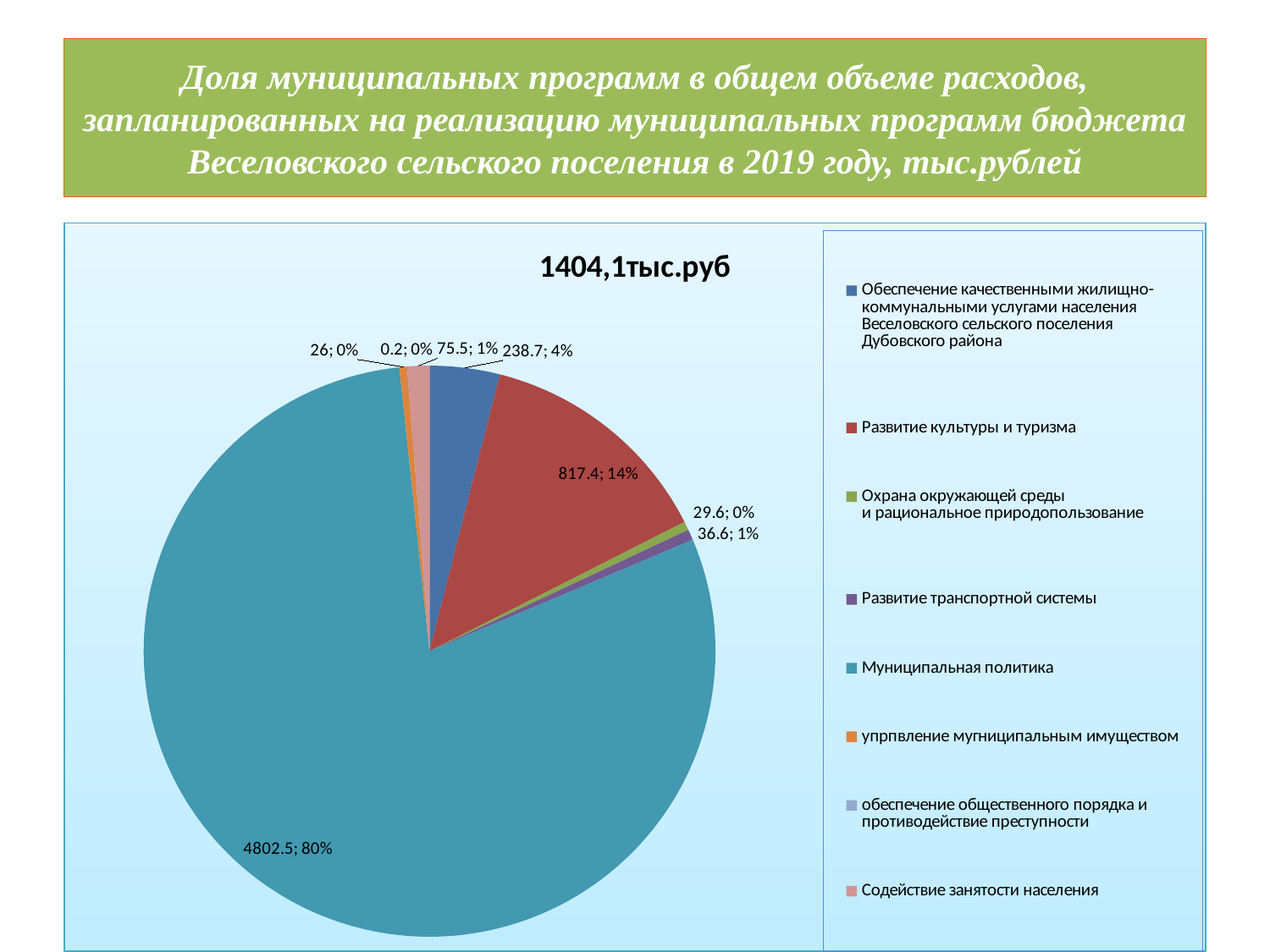
What value is shown for the Развитие культуры и туризма slice? 817.4 What is the smallest value labelled on the pie chart? 0.2 What is the title shown above the pie chart? 1404,1тыс.руб What share of the pie does the Развитие культуры и туризма slice represent? 14% What kind of chart is shown on the slide? pie chart What share of the pie does the Муниципальная политика slice represent? 80% Which category has the largest slice of the pie? Муниципальная политика What is the difference between the values for Муниципальная политика and Развитие культуры и туризма? 3985.1 How many entries does the legend of the pie chart list? 8 What value is shown for the Муниципальная политика slice? 4802.5 What colour is the slice for Муниципальная политика? teal Which is larger: the slice for Муниципальная политика or the slice for Развитие культуры и туризма? Муниципальная политика